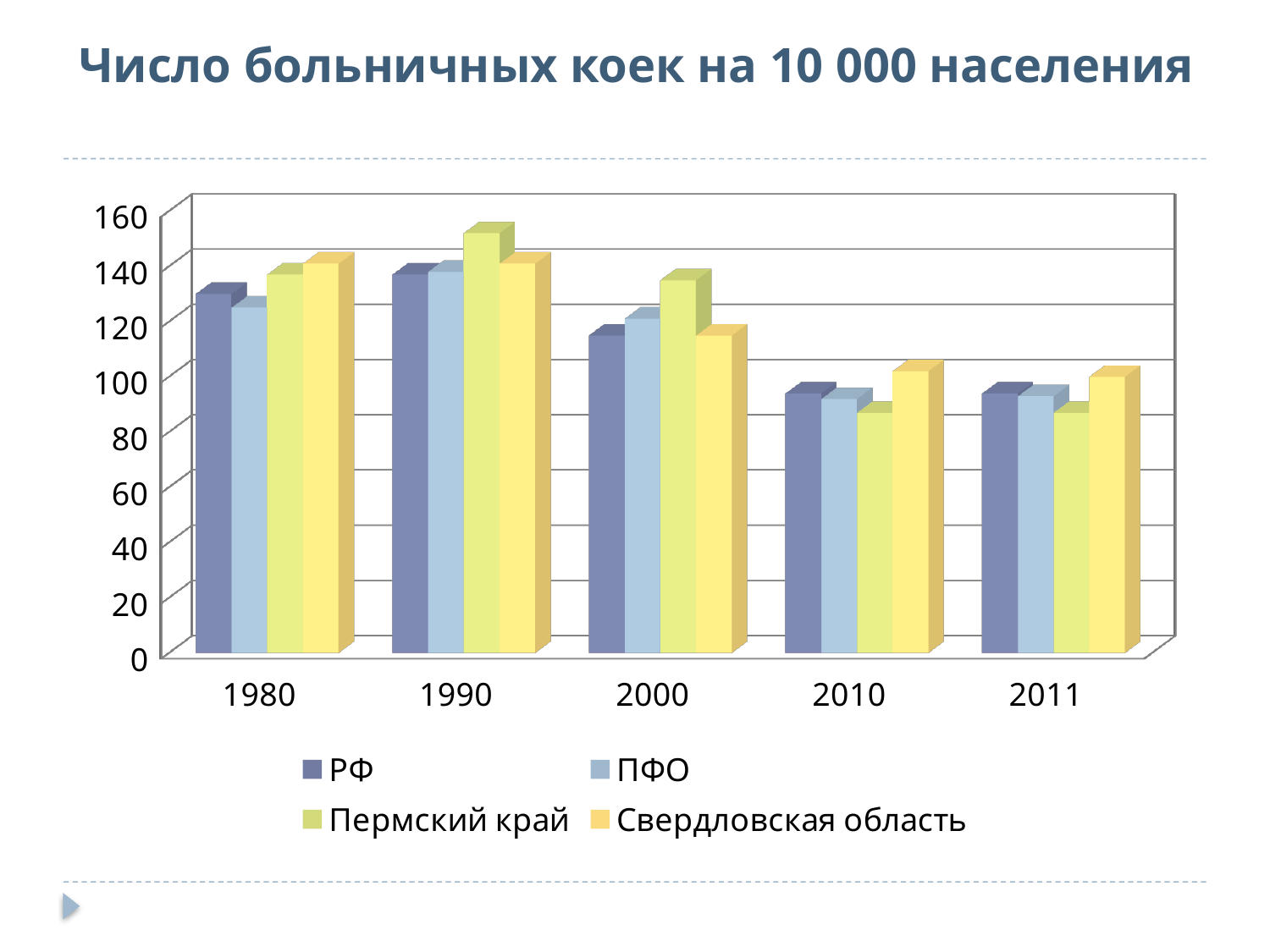
Which series is shown in yellow in the legend? Свердловская область What is the title of the chart? Число больничных коек на 10 000 населения How many series does the legend list? 4 In 2010, which series has the lowest value? Пермский край Is the value for Свердловская область in 2011 greater or less than 80? greater Is the value for Пермский край in 1990 greater or less than 140? greater How many year categories are shown on the x axis? 5 What kind of chart is shown on the slide? bar chart In which year is the value for Пермский край highest? 1990 Do the values for РФ rise or fall from 1980 to 2011? fall In 2000, which is larger: the value for Пермский край or the value for РФ? Пермский край Is the value for Пермский край in 2010 greater or less than 100? less